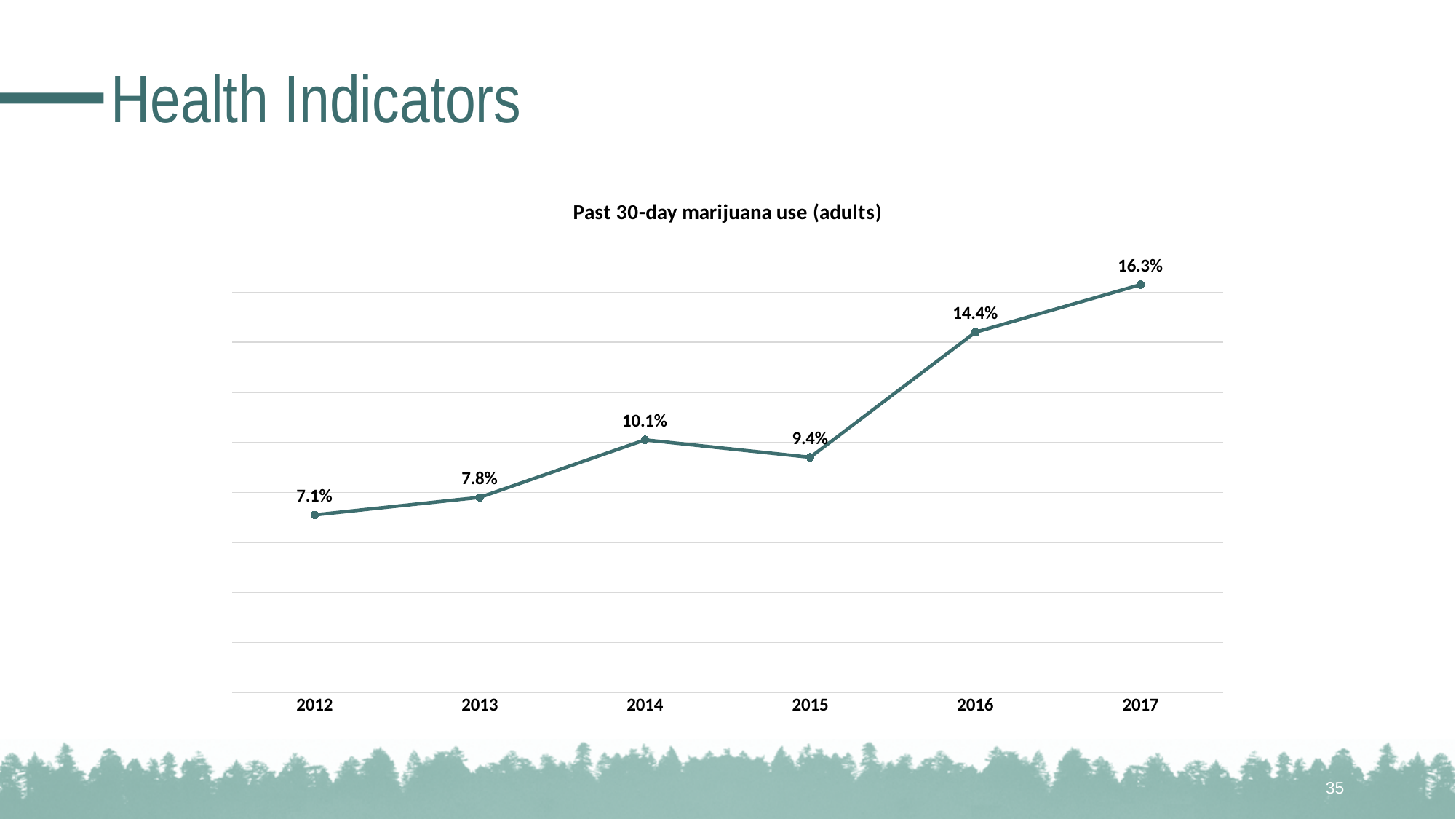
What kind of chart is shown? line chart What is the value for 2015? 9.4% What is the title of the chart? Past 30-day marijuana use (adults) What is the value for 2017? 16.3% Which year has the lowest value? 2012 Which is larger, the value for 2014 or the value for 2015? 2014 Do the values generally rise or fall from 2012 to 2017? rise How many years are plotted on the chart? 6 What is the difference between the values for 2017 and 2016? 1.9% What is the value for 2012? 7.1% Which year has the highest value? 2017 What is the difference between the values for 2014 and 2015? 0.7%